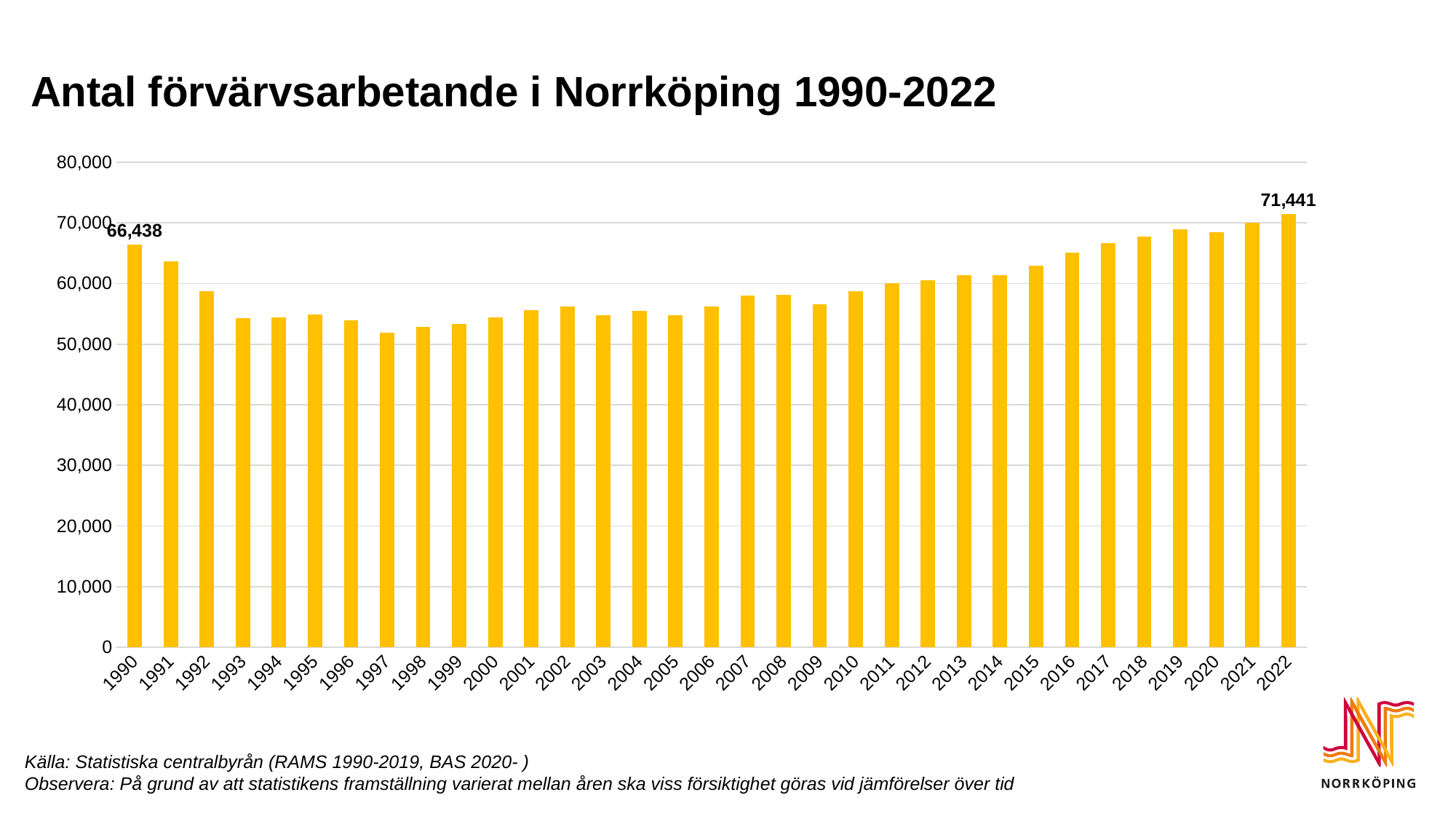
Which year has the highest value? 2022 Which is larger, the value for 1990 or the value for 1991? 1990 How many years are shown on the x axis? 33 What is the value for 1990? 66,438 What is the title of the chart? Antal förvärvsarbetande i Norrköping 1990-2022 Is the value for 1993 greater or less than 60,000? less Is the value for 2021 greater or less than 60,000? greater What is the difference between the values for 2022 and 1990? 5,003 Which year has the lowest value? 1997 What kind of chart is shown on the slide? Bar chart Do the values rise or fall from 2009 to 2022? rise What is the value for 2022? 71,441